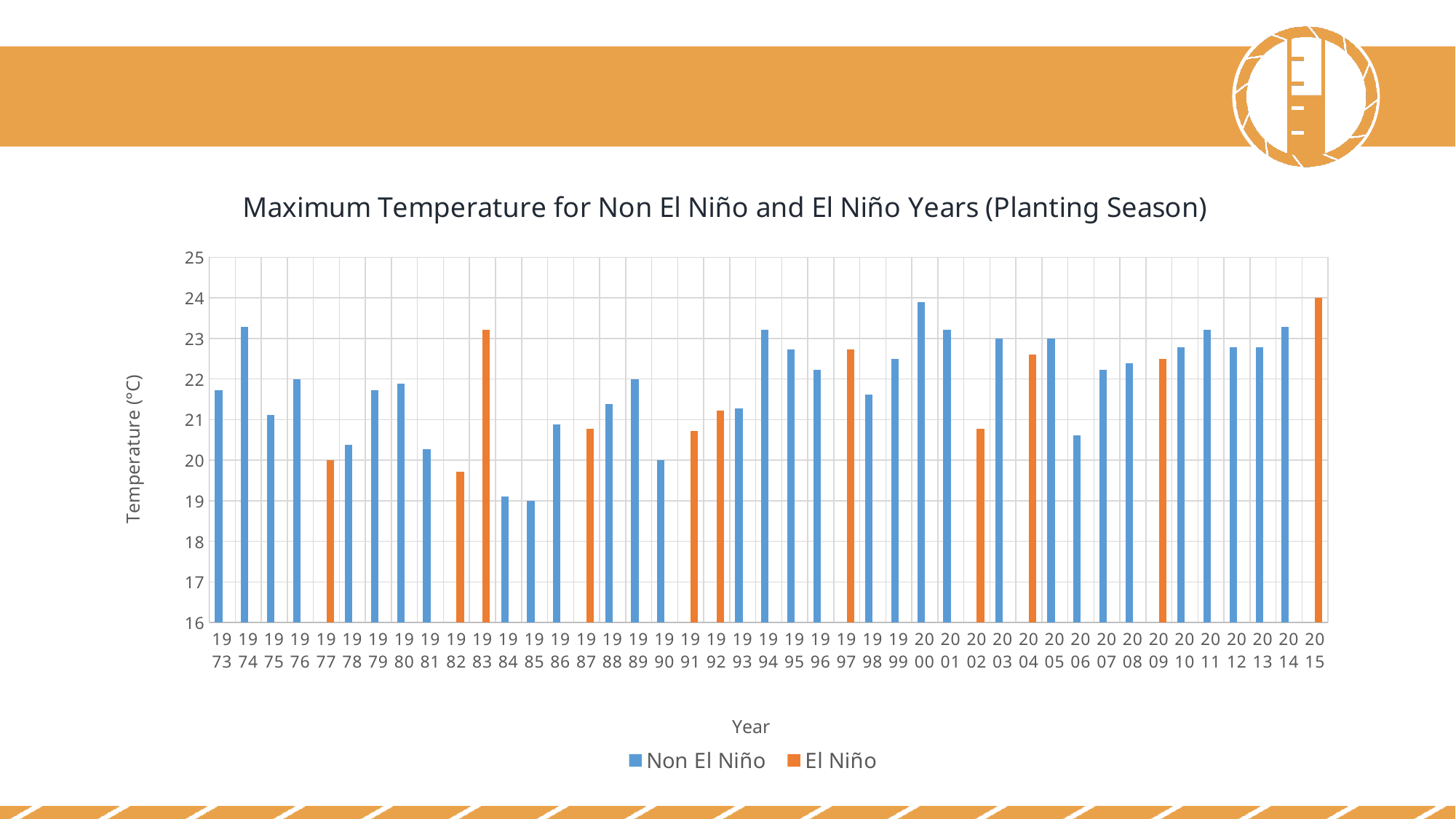
Which year has the higher maximum temperature, 1974 or 1975? 1974 What is the maximum temperature for 2015? 24 What is the maximum temperature for 1977? 20 What kind of chart is shown on the slide? bar chart What colour are the El Niño bars? orange Which year has the higher maximum temperature, 2000 or 2006? 2000 Is the value for 1974 greater or less than 23? greater Is the value for 1984 greater or less than 20? less Is the value for 2006 greater or less than 21? less How many years are plotted along the x axis? 43 How many series does the legend list? 2